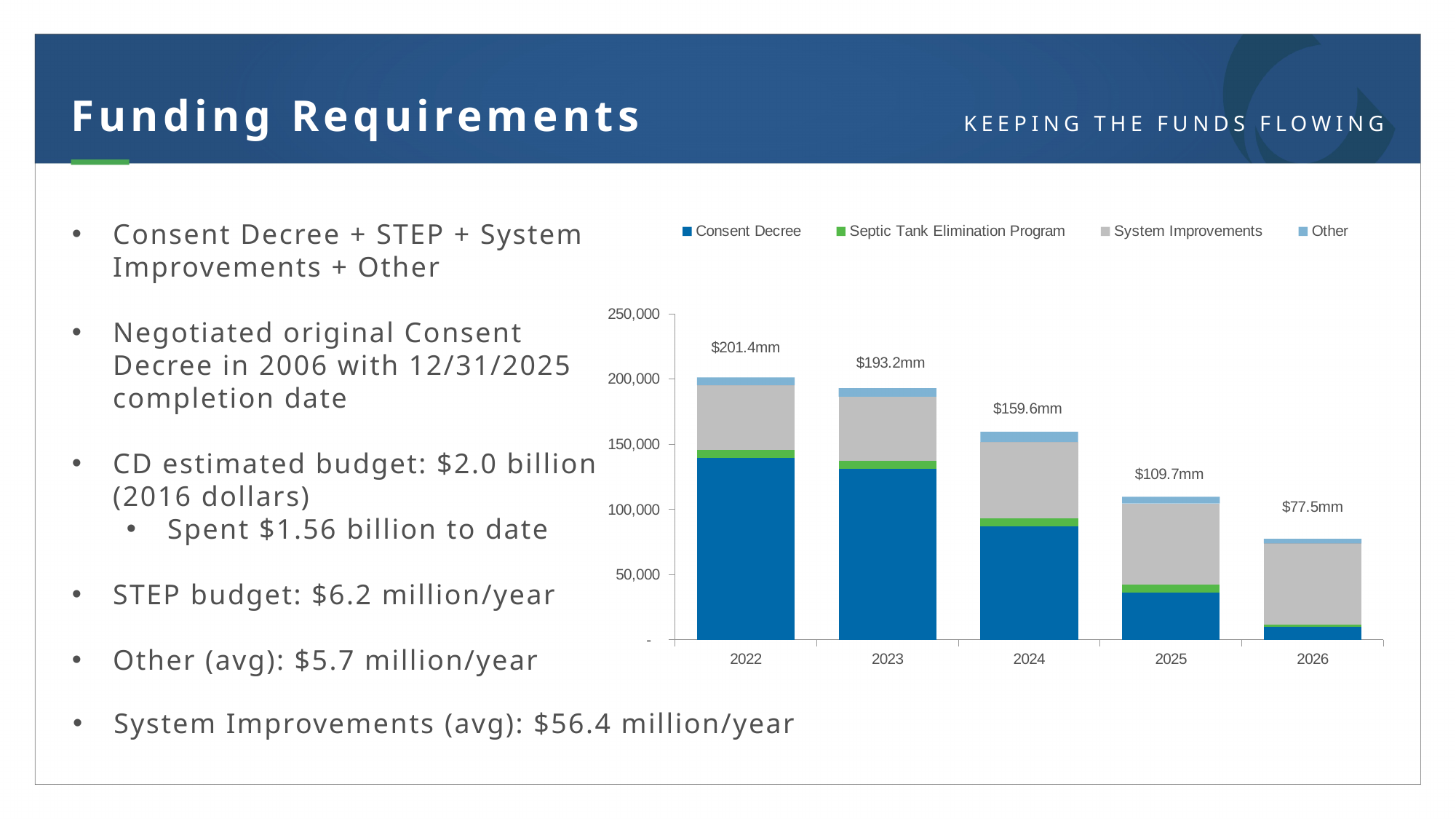
How many years are shown on the x axis of the chart? 5 What kind of chart is shown on the slide? Stacked bar chart How many series does the chart legend list? 4 What is the difference between the 2022 total and the 2023 total? $8.2mm What is the total labeled above the 2025 bar? $109.7mm What is the difference between the 2024 total and the 2026 total? $82.1mm Is the Consent Decree value for 2022 greater or less than 100,000? greater Is the Consent Decree value for 2025 greater or less than 50,000? less Which year has a larger total, 2024 or 2025? 2024 What is the total labeled above the 2022 bar? $201.4mm Which year has the highest total funding requirement? 2022 Which year has the lowest total funding requirement? 2026